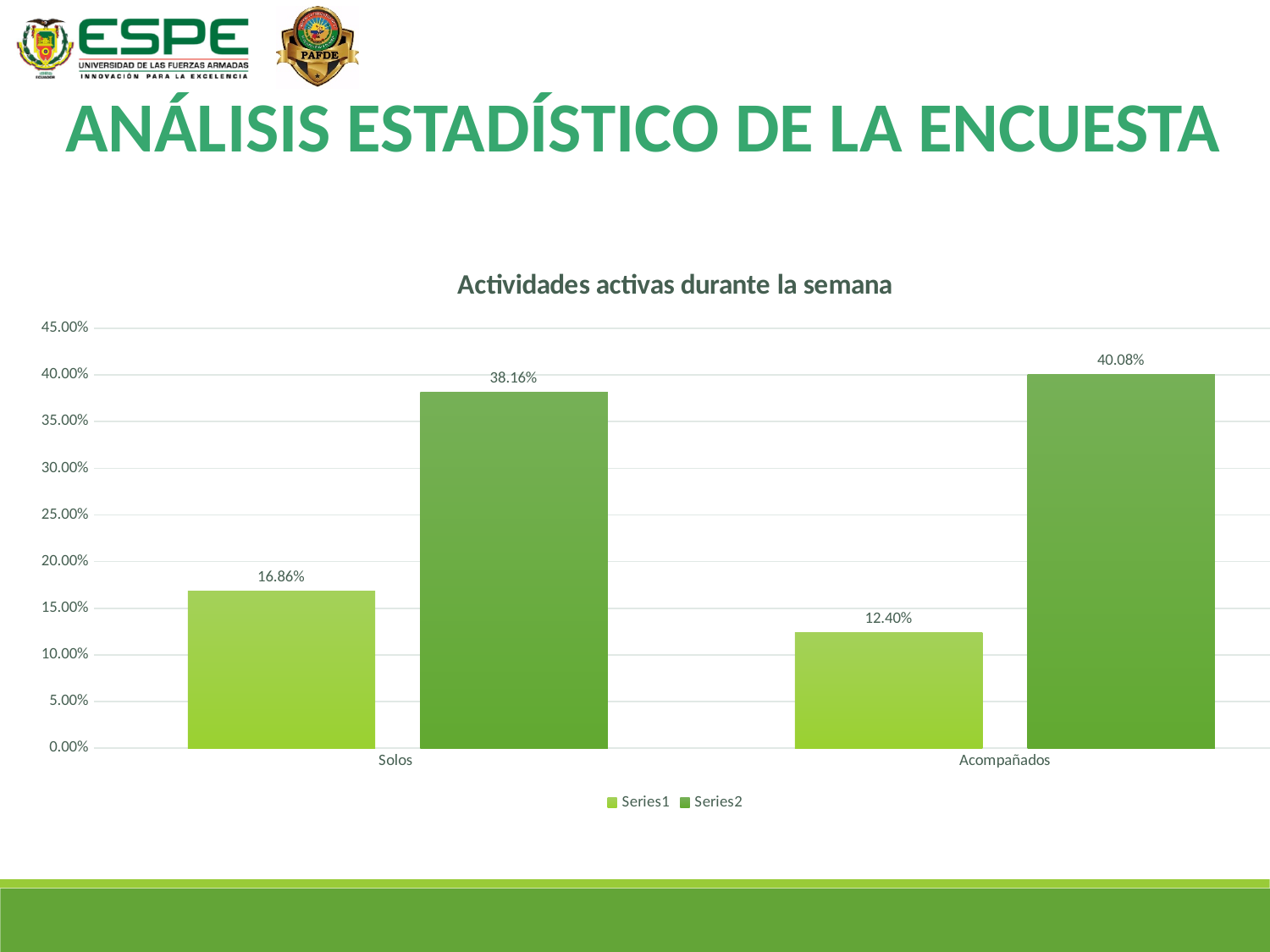
Which category has the lowest Series1 value? Acompañados What is the value of Series2 for Acompañados? 40.08% What is the value of Series2 for Solos? 38.16% How many categories are shown on the x axis? 2 How many series does the legend list? 2 Which is larger for Acompañados, Series1 or Series2? Series2 What is the difference between Series2 and Series1 for Solos? 21.30% What is the title of the chart? Actividades activas durante la semana What kind of chart is shown on the slide? Bar chart Which category has the highest Series2 value? Acompañados What is the value of Series1 for Acompañados? 12.40% What is the value of Series1 for Solos? 16.86%